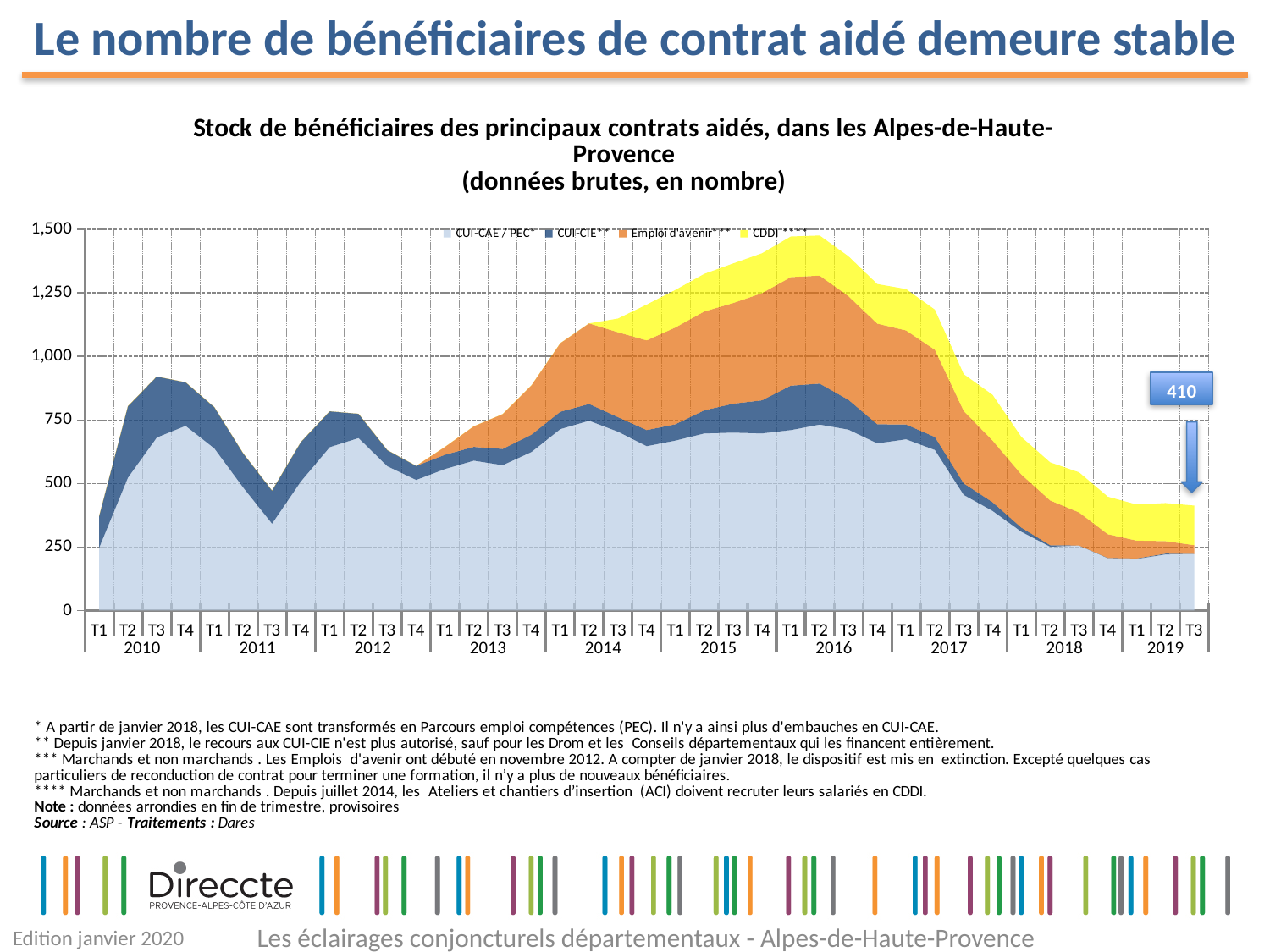
Is the total stock of beneficiaries in T1 2010 greater or less than 500? less What kind of chart is shown on the slide? Stacked area chart What is the title of the chart? Stock de bénéficiaires des principaux contrats aidés, dans les Alpes-de-Haute-Provence (données brutes, en nombre) Is the total stock of beneficiaries in T3 2011 greater or less than 750? less In which year does the total stock of beneficiaries reach its highest level? 2016 What is the total stock of beneficiaries labelled for T3 2019? 410 Is the total stock of beneficiaries in T2 2014 greater or less than 1,000? greater How many series does the legend list? 4 How many years are shown on the x axis? 10 Does the total stock of beneficiaries rise or fall from 2016 to 2019? fall Which series is shown in light blue at the bottom of the stack? CUI-CAE / PEC*